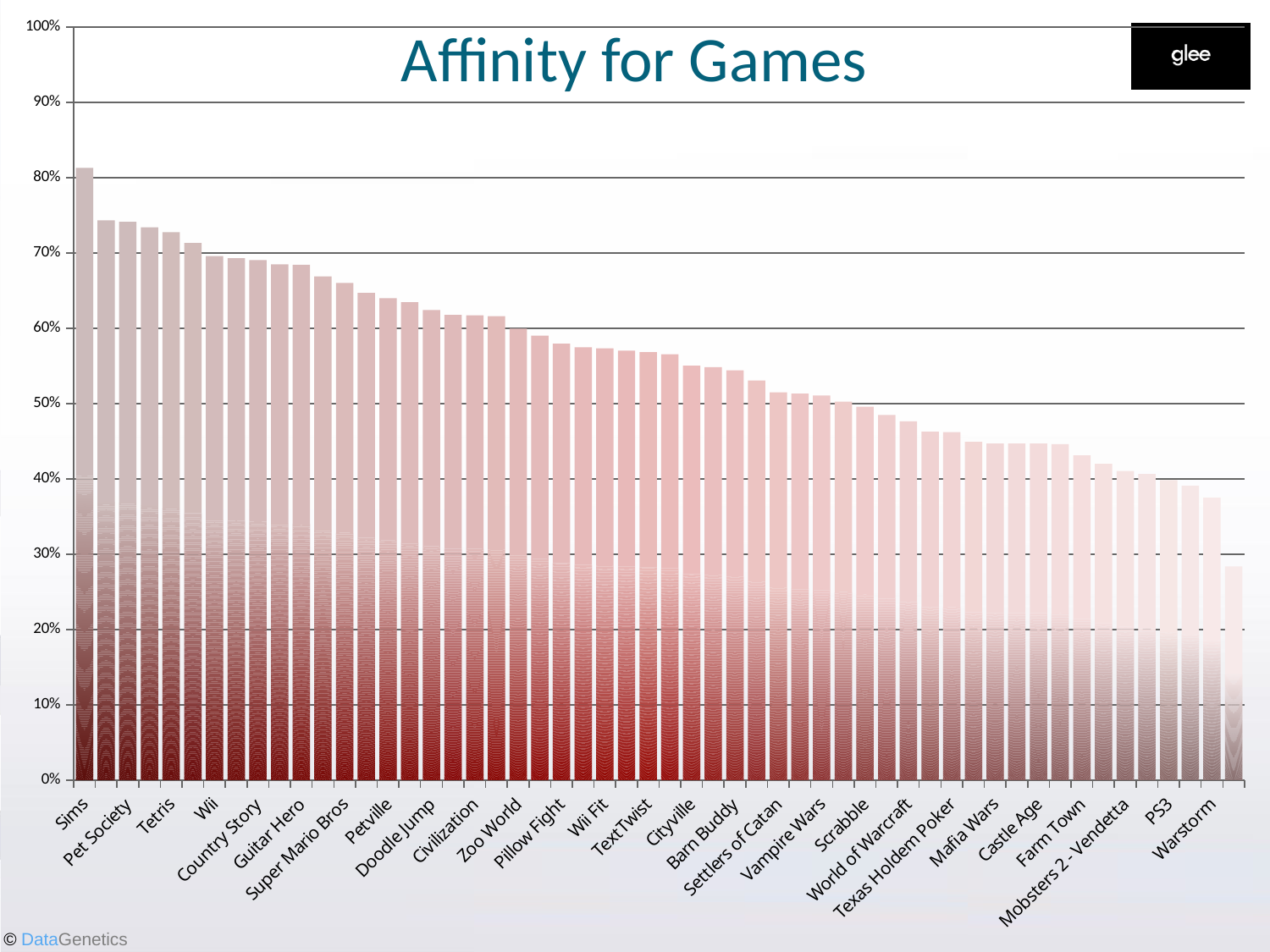
Is the value for Scrabble greater or less than 60%? less Which game has the highest affinity value? Sims What is the title of the chart? Affinity for Games Is the value for Tetris greater or less than 60%? greater Is the value for Warstorm greater or less than 40%? less Do the values rise or fall moving from left to right along the x axis? fall What kind of chart is shown on the slide? bar chart Which has a higher affinity value, Mafia Wars or Guitar Hero? Guitar Hero Which has a higher affinity value, Tetris or Scrabble? Tetris Which has a higher affinity value, Sims or Pet Society? Sims